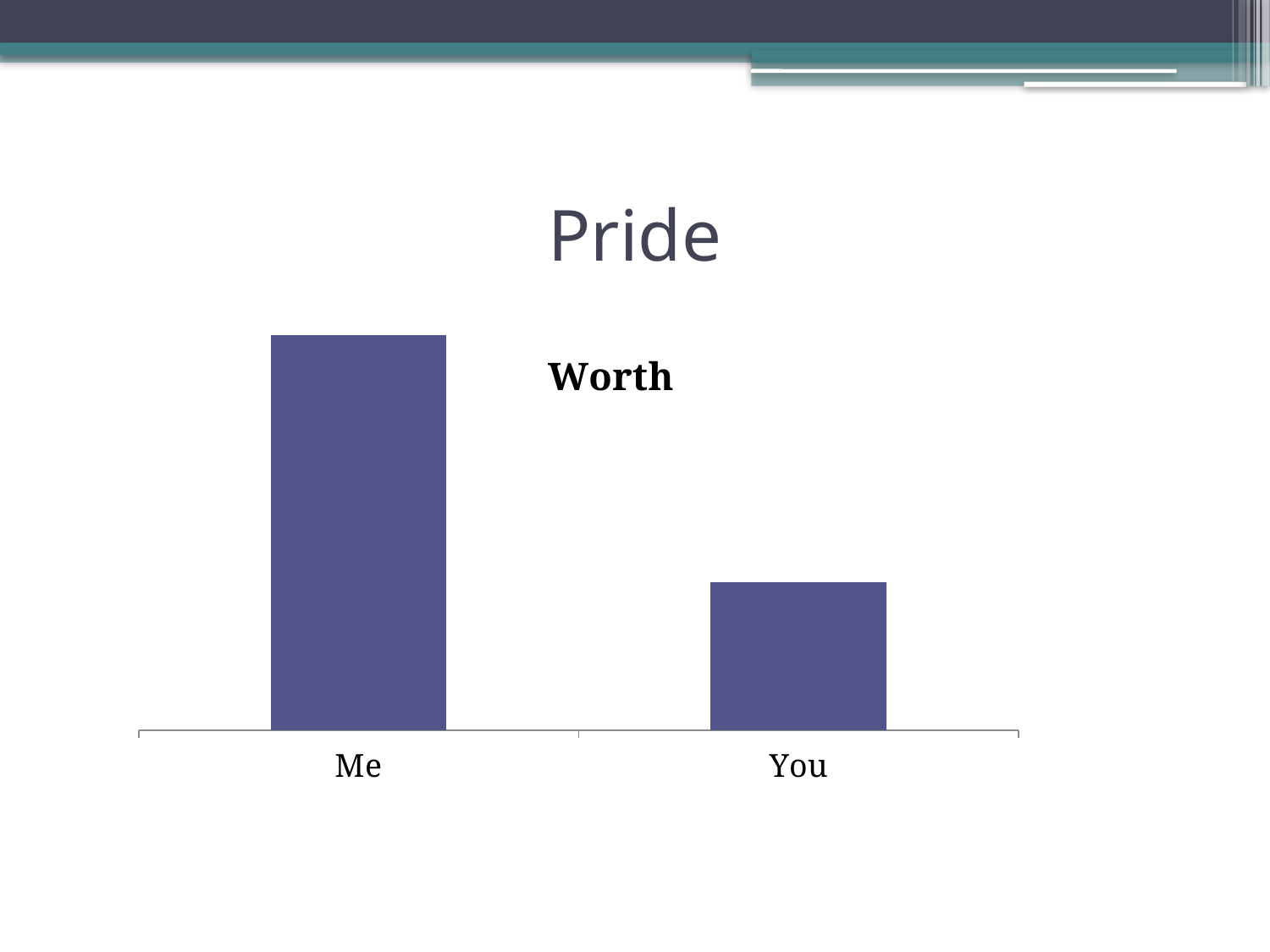
What is the title of the slide? Pride Which category has the lowest bar in the chart? You Do the bar values rise or fall from Me to You along the x axis? fall What is the title of the chart? Worth How many categories are shown on the x axis of the chart? 2 What kind of chart is shown on the slide? bar chart Which category has the highest bar in the chart? Me Is the bar for Me larger or smaller than the bar for You? larger